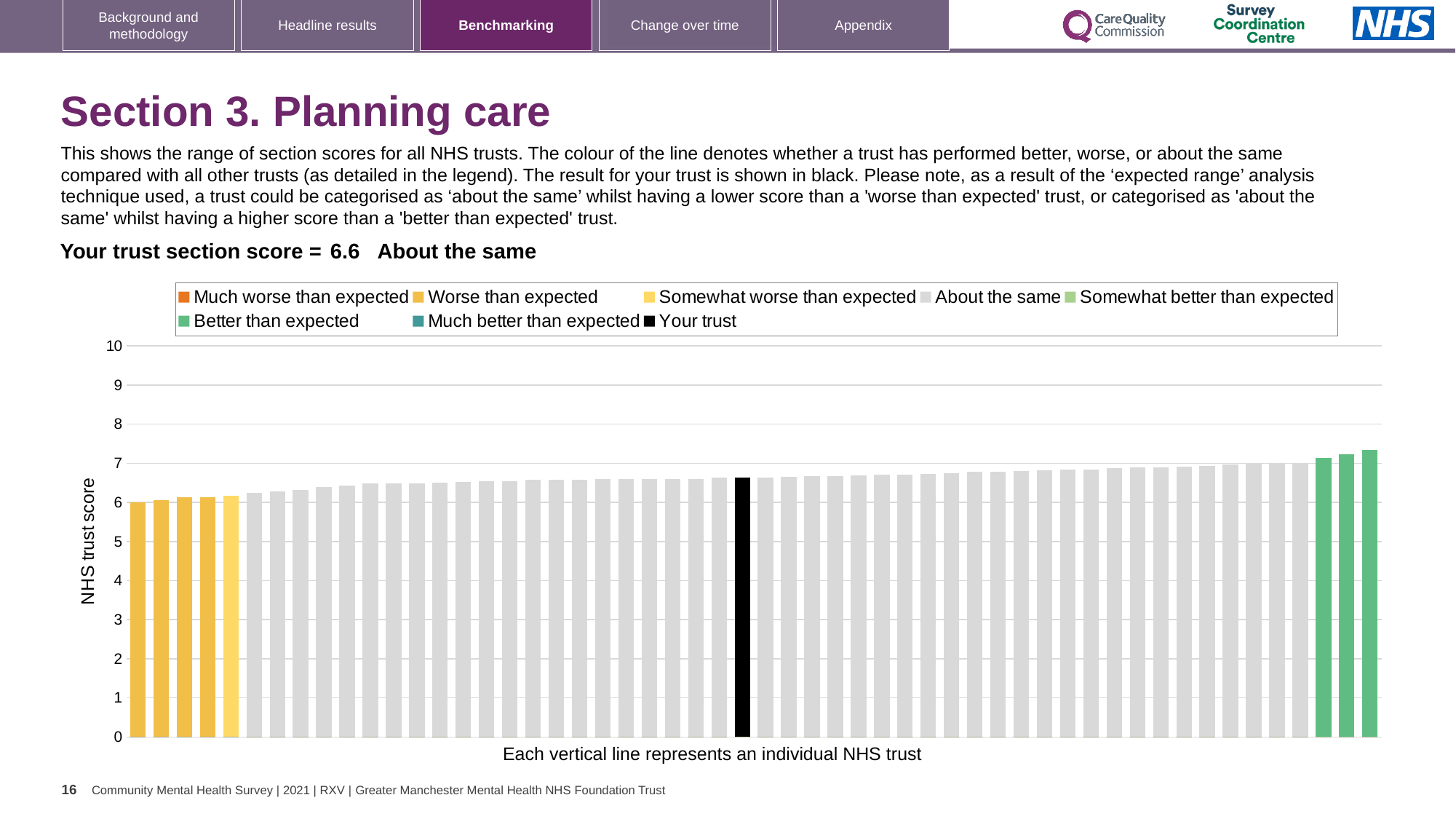
What is the section score for your trust (the black bar)? 6.6 Is the value of the rightmost bar greater or less than 7? greater What is the label of the y axis? NHS trust score What kind of chart is shown on the slide? bar chart How many entries does the chart legend list? 8 How many bars are coloured dark yellow ('Worse than expected')? 4 Do the bar values rise or fall from left to right along the x axis? rise How is your trust's section score categorised compared with other trusts? About the same What is the maximum value shown on the y axis? 10 Is the value of the leftmost bar greater or less than 5? greater Is the value of the black 'Your trust' bar greater or less than 7? less How many bars are coloured green ('Better than expected')? 3